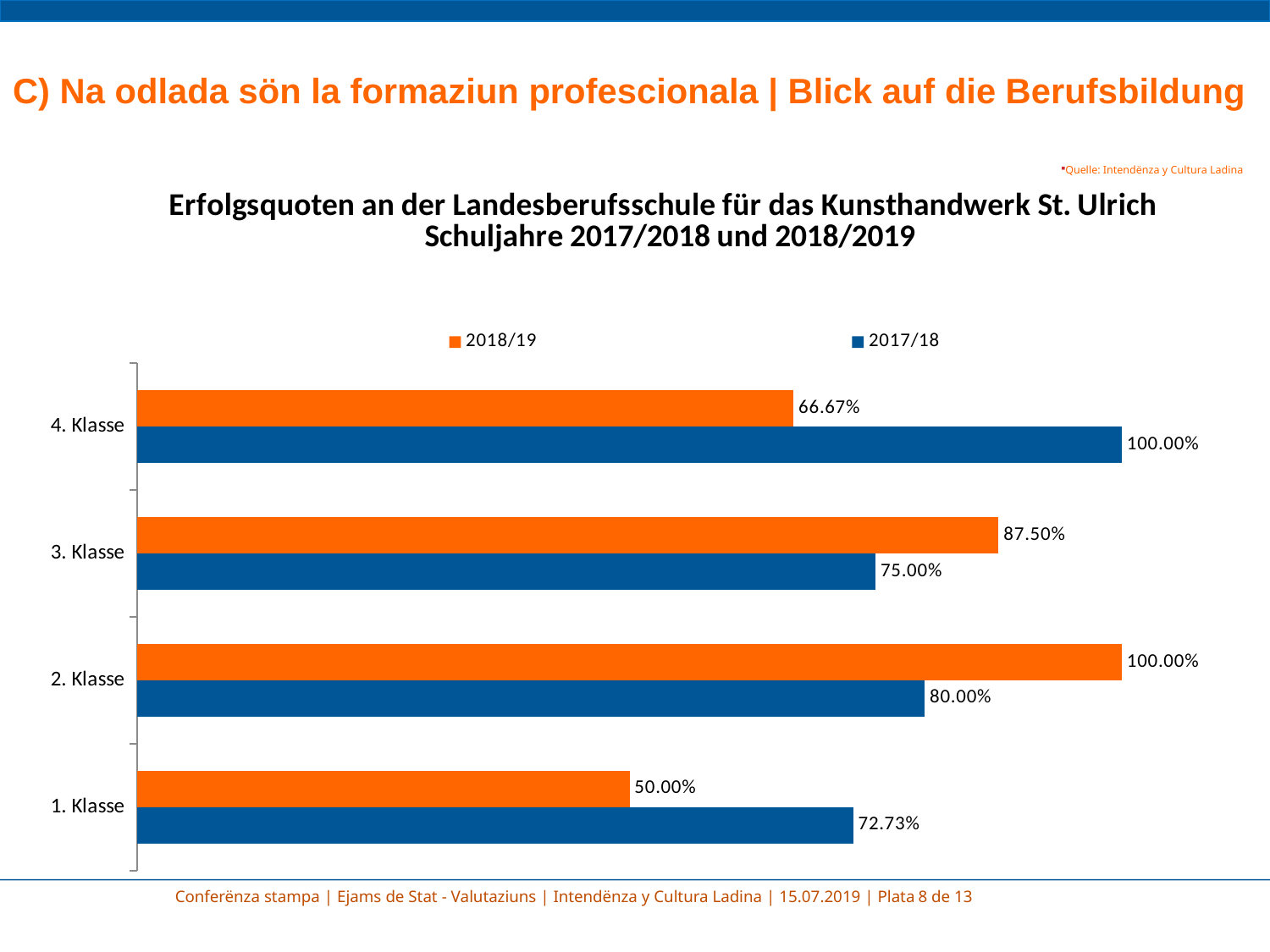
What is the success rate for 4. Klasse in 2017/18? 100.00% What is the success rate for 2. Klasse in 2018/19? 100.00% What is the success rate for 1. Klasse in 2017/18? 72.73% What is the difference between the 2017/18 and 2018/19 success rates for 4. Klasse? 33.33% How many classes are shown on the chart? 4 What is the success rate for 3. Klasse in 2018/19? 87.50% Which class has the lowest success rate in 2017/18? 1. Klasse What kind of chart is shown on the slide? Bar chart Which class has the lowest success rate in 2018/19? 1. Klasse How many series does the legend list? 2 What is the difference between the 2018/19 and 2017/18 success rates for 3. Klasse? 12.50% For 1. Klasse, which school year has the higher success rate, 2017/18 or 2018/19? 2017/18